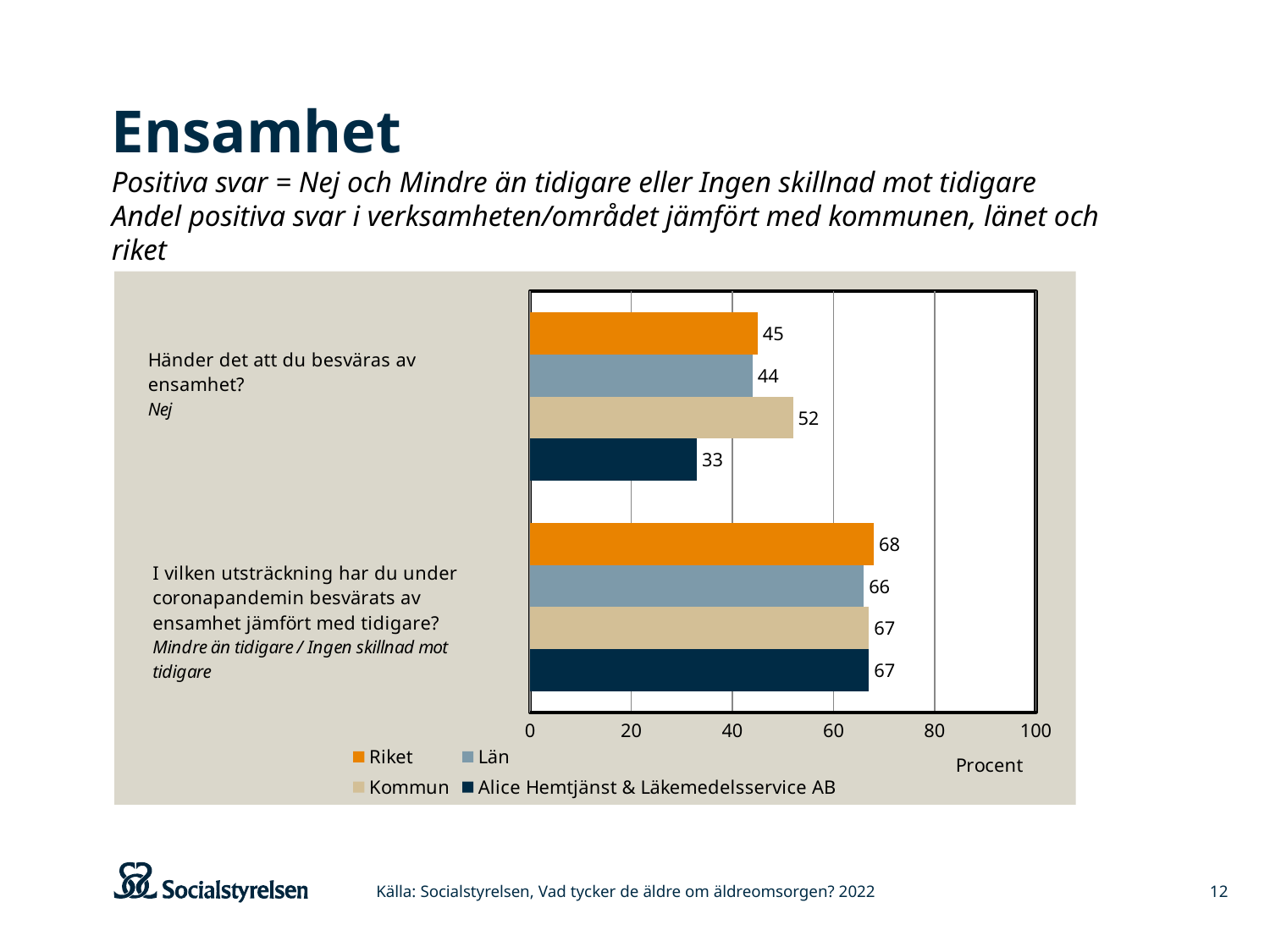
What is the value for Alice Hemtjänst & Läkemedelsservice AB on the question 'Händer det att du besväras av ensamhet?' 33 What is the value for Kommun on the question 'I vilken utsträckning har du under coronapandemin besvärats av ensamhet jämfört med tidigare?' 67 How many series does the legend list? 4 What is the difference between the Riket value and the Län value on the question 'I vilken utsträckning har du under coronapandemin besvärats av ensamhet jämfört med tidigare?' 2 What is the value for Riket on the question 'Händer det att du besväras av ensamhet?' 45 What label is shown on the horizontal axis of the chart? Procent What is the value for Län on the question 'I vilken utsträckning har du under coronapandemin besvärats av ensamhet jämfört med tidigare?' 66 What kind of chart is shown on the slide? Bar chart Which series has the lowest value on the question 'Händer det att du besväras av ensamhet?' Alice Hemtjänst & Läkemedelsservice AB Which is larger on the question 'Händer det att du besväras av ensamhet?': the value for Riket or the value for Län? Riket What is the difference between the Kommun value and the Alice Hemtjänst & Läkemedelsservice AB value on the question 'Händer det att du besväras av ensamhet?' 19 Which series has the highest value on the question 'Händer det att du besväras av ensamhet?' Kommun